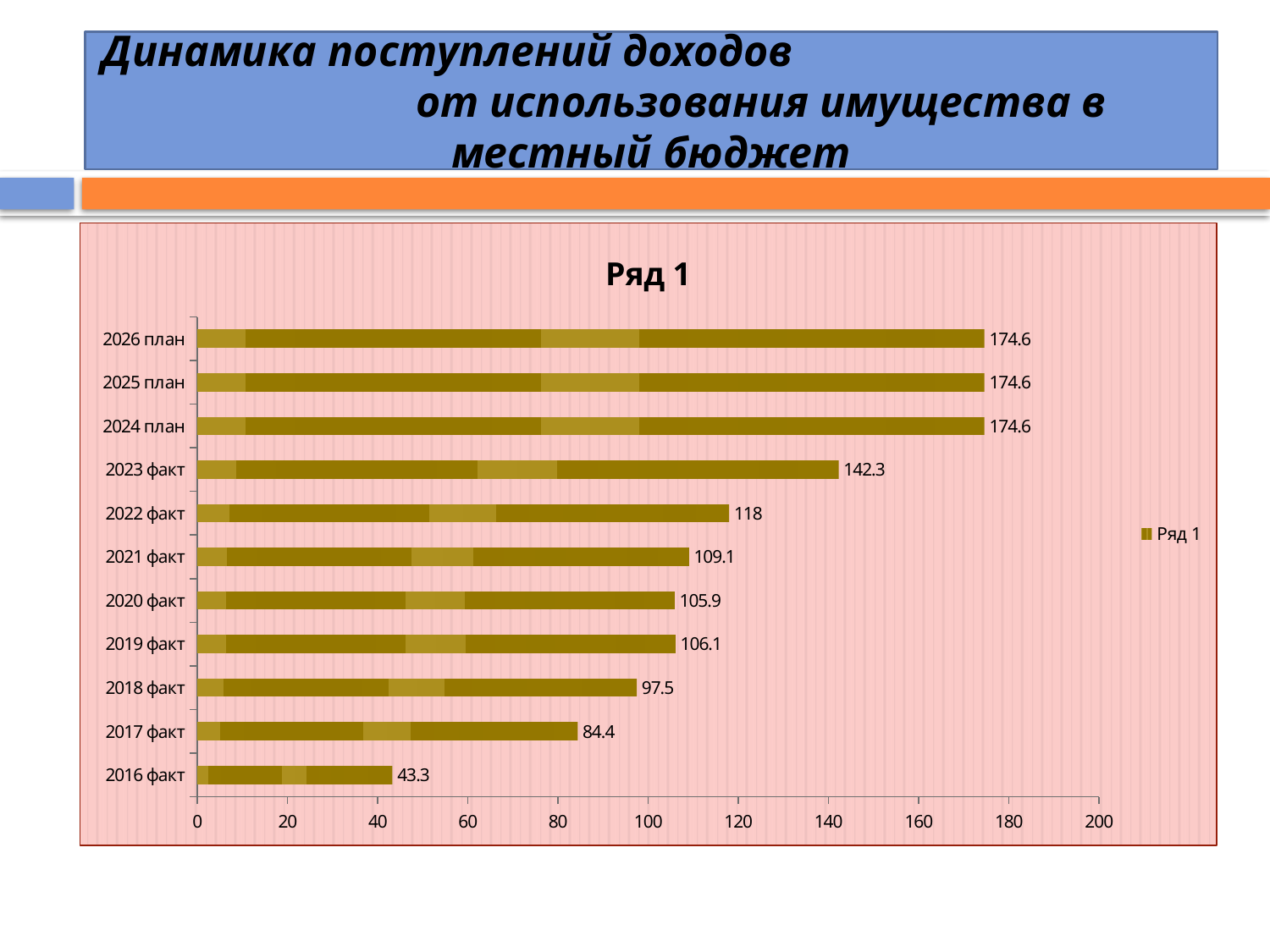
What is the value for 2021 факт? 109.1 What is the value for 2023 факт? 142.3 Which category has the lowest value? 2016 факт Is the value for 2018 факт greater or less than 100? less What is the difference between the values for 2017 факт and 2016 факт? 41.1 What is the title of the chart? Ряд 1 What is the value for 2016 факт? 43.3 Which is larger, the value for 2022 факт or 2021 факт? 2022 факт What is the difference between the values for 2023 факт and 2022 факт? 24.3 What kind of chart is shown on the slide? bar chart How many categories are shown on the chart? 11 What is the value for 2025 план? 174.6